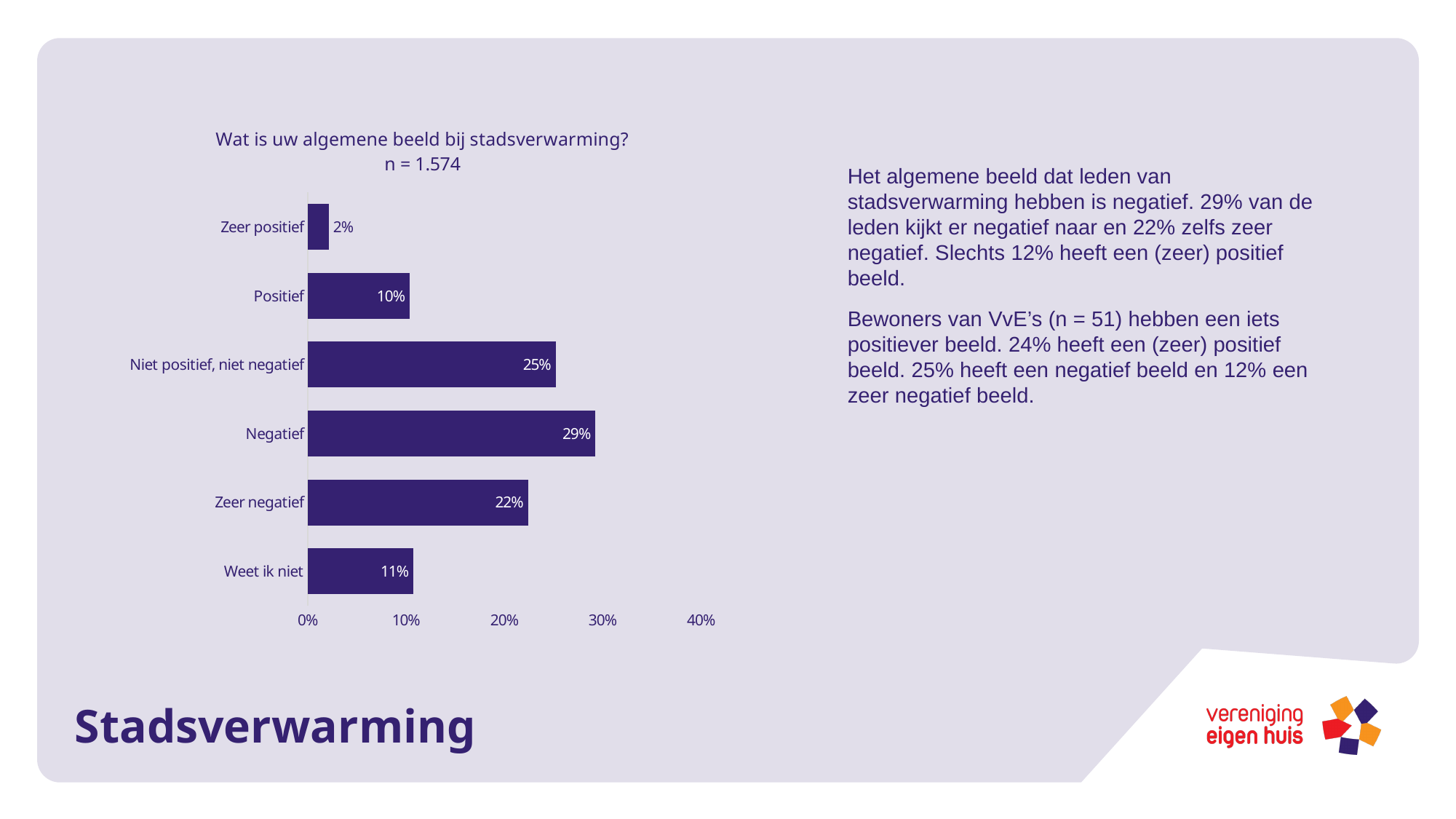
What is the title of the chart? Wat is uw algemene beeld bij stadsverwarming? What is the difference between the values for "Negatief" and "Zeer negatief"? 7% Which category has the lowest value? Zeer positief Which is larger, the value for "Positief" or the value for "Weet ik niet"? Weet ik niet What is the sample size (n) stated in the chart title? 1.574 How many categories are shown in the chart? 6 What is the value for "Weet ik niet"? 11% What kind of chart is shown on the slide? bar chart What is the value for "Negatief"? 29% Is the value for "Niet positief, niet negatief" greater or less than 20%? greater Which category has the highest value? Negatief What is the value for "Zeer positief"? 2%